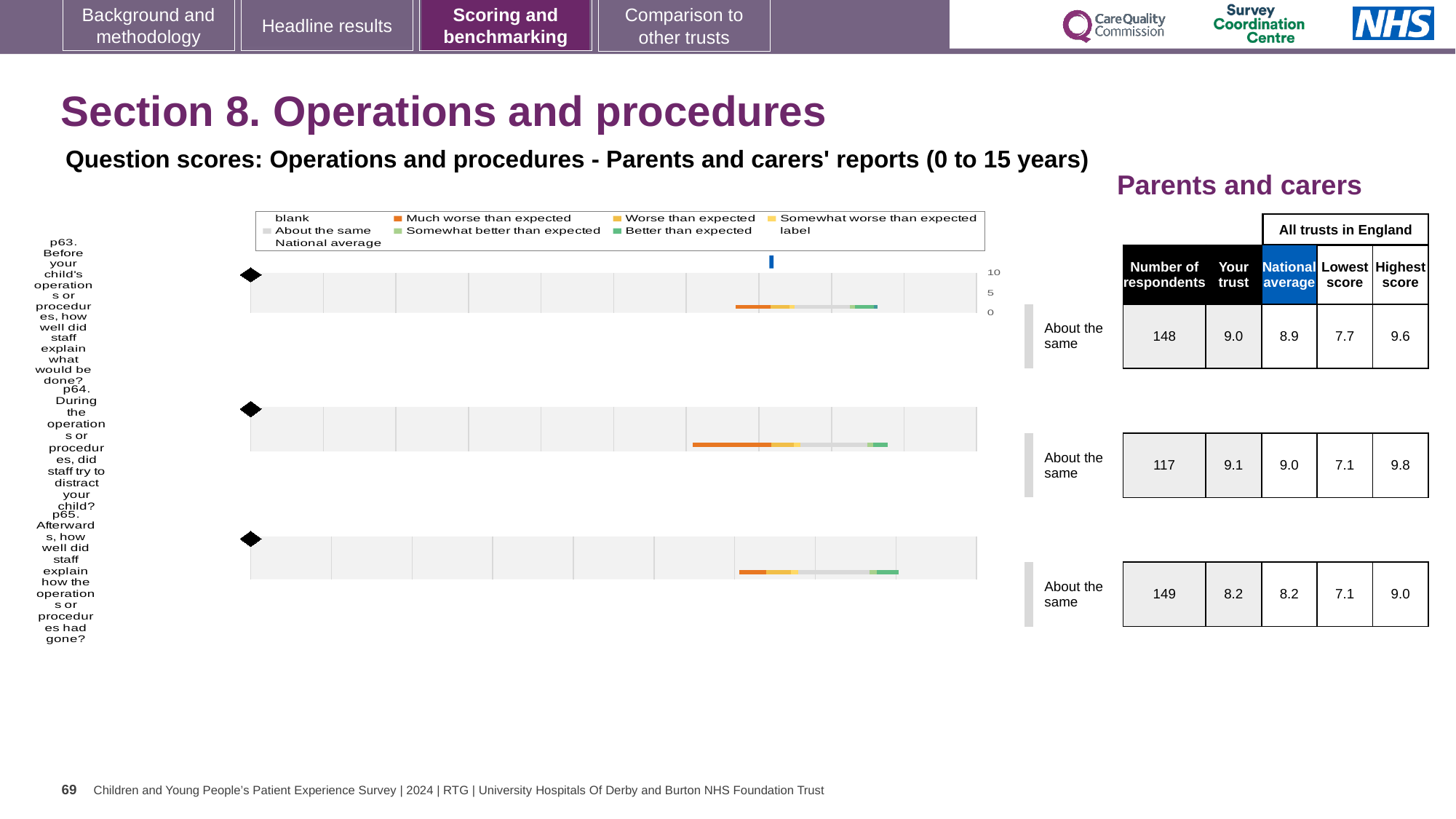
For p63, what is the difference between the highest score (9.6) and the lowest score (7.7) across all trusts in England? 1.9 What kind of chart is used to show the question scores for p63, p64 and p65? Bar chart How many questions (p63, p64, p65) are plotted on the slide? 3 Which question has the lowest 'Your trust' score? p65 How many respondents answered p65 (how well staff explained how the operation had gone)? 149 Which question has the highest 'Your trust' score? p64 What is the national average score for p64 (did staff try to distract your child during the operation)? 9.0 What is the lowest score across all trusts in England for p65? 7.1 What colour does the legend use for 'Much worse than expected'? Orange What benchmark category is shown for p64? About the same What is the 'Your trust' score for p63 (how well staff explained what would be done before the operation)? 9.0 For p63, which is larger: the 'Your trust' score or the national average? Your trust